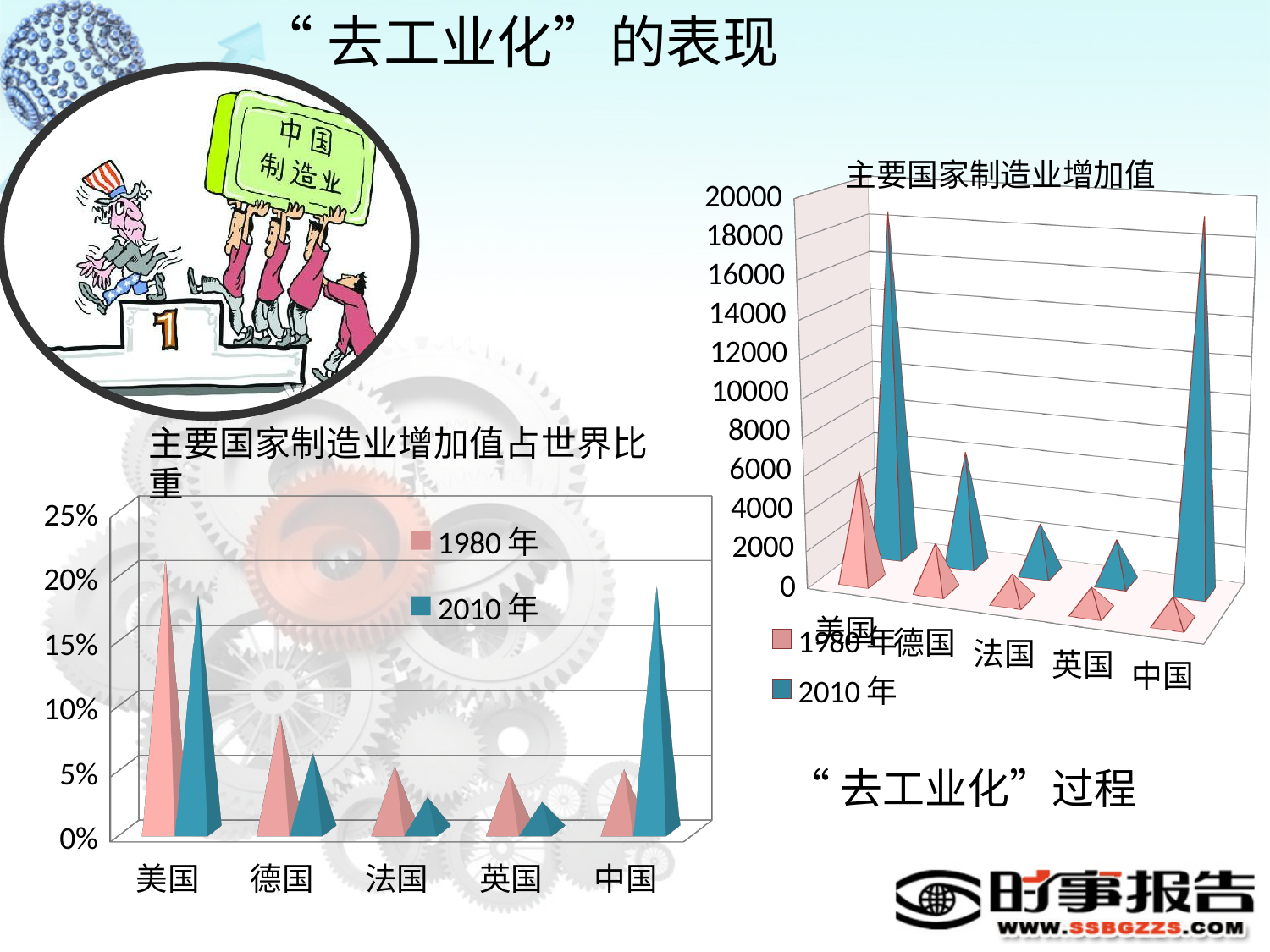
On the chart titled 主要国家制造业增加值, which is larger for 美国: the 1980年 value or the 2010年 value? 2010年 On the chart titled 主要国家制造业增加值占世界比重, how many countries are shown on the x axis? 5 On the chart titled 主要国家制造业增加值占世界比重, is the value for 德国 in 1980年 greater or less than 10%? less On the chart titled 主要国家制造业增加值占世界比重, which is larger for 中国: the 1980年 value or the 2010年 value? 2010年 On the chart titled 主要国家制造业增加值占世界比重, which country has the highest value for 1980年? 美国 On the chart titled 主要国家制造业增加值, is the value for 中国 in 1980年 greater or less than 2000? less On the chart titled 主要国家制造业增加值占世界比重, is the value for 中国 in 2010年 greater or less than 15%? greater On the chart titled 主要国家制造业增加值, which country has the highest value for 1980年? 美国 What kind of chart is the chart titled 主要国家制造业增加值? bar chart On the chart titled 主要国家制造业增加值, which country has the lowest value for 1980年? 英国 On the chart titled 主要国家制造业增加值, how many series does the legend list? 2